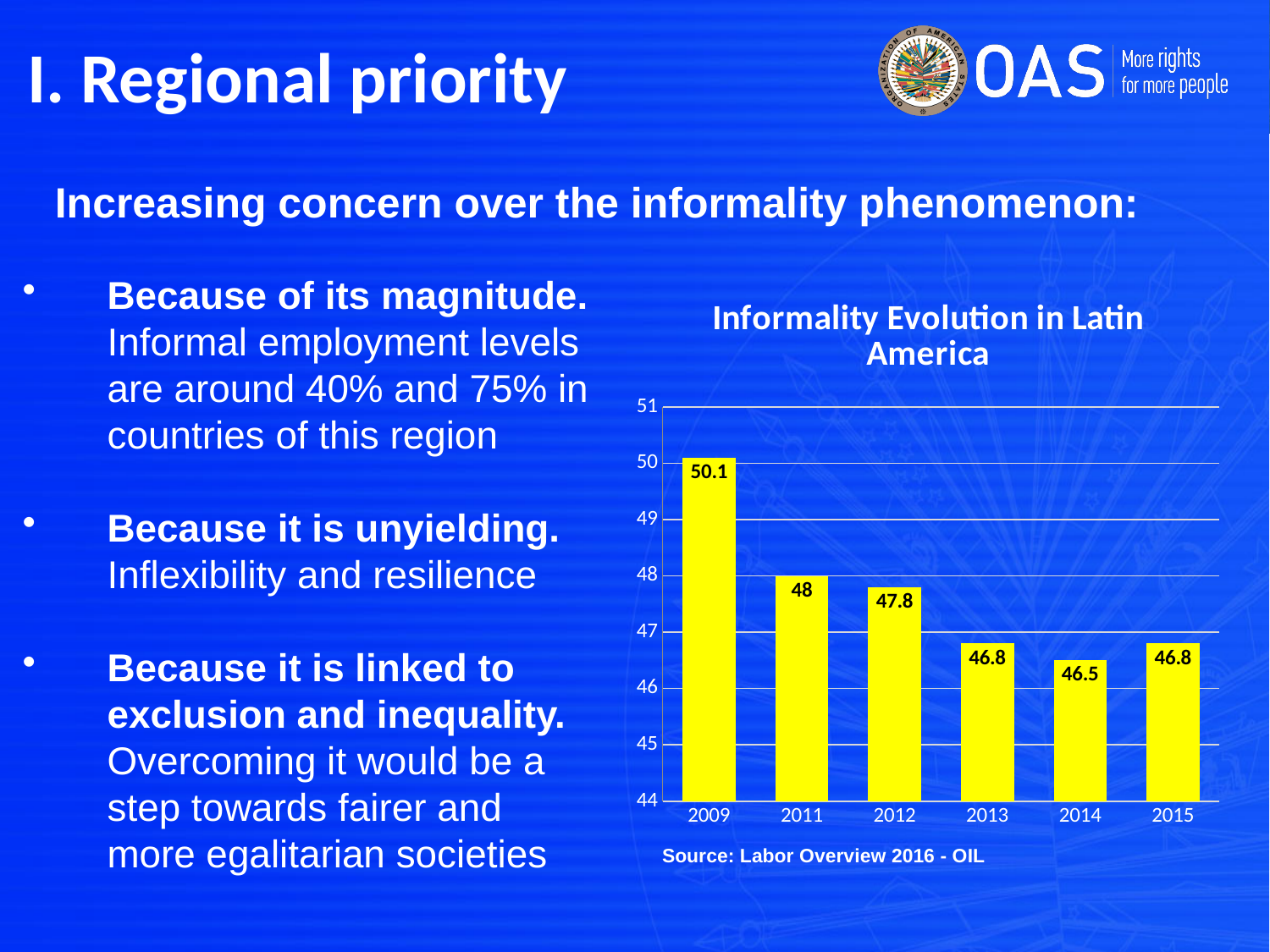
What kind of chart is shown on the slide? bar chart Which year has the highest value in the chart? 2009 What is the difference between the values for 2009 and 2015? 3.3 What is the value for 2014 in the chart? 46.5 Which is larger, the value for 2011 or the value for 2013? 2011 How many years are shown on the x axis of the chart? 6 What is the title of the chart on the slide? Informality Evolution in Latin America What is the value for 2012 in the chart? 47.8 Is the value for 2013 greater or less than 47? less What is the difference between the values for 2011 and 2012? 0.2 What is the value for 2009 in the Informality Evolution in Latin America chart? 50.1 Which year has the lowest value in the chart? 2014